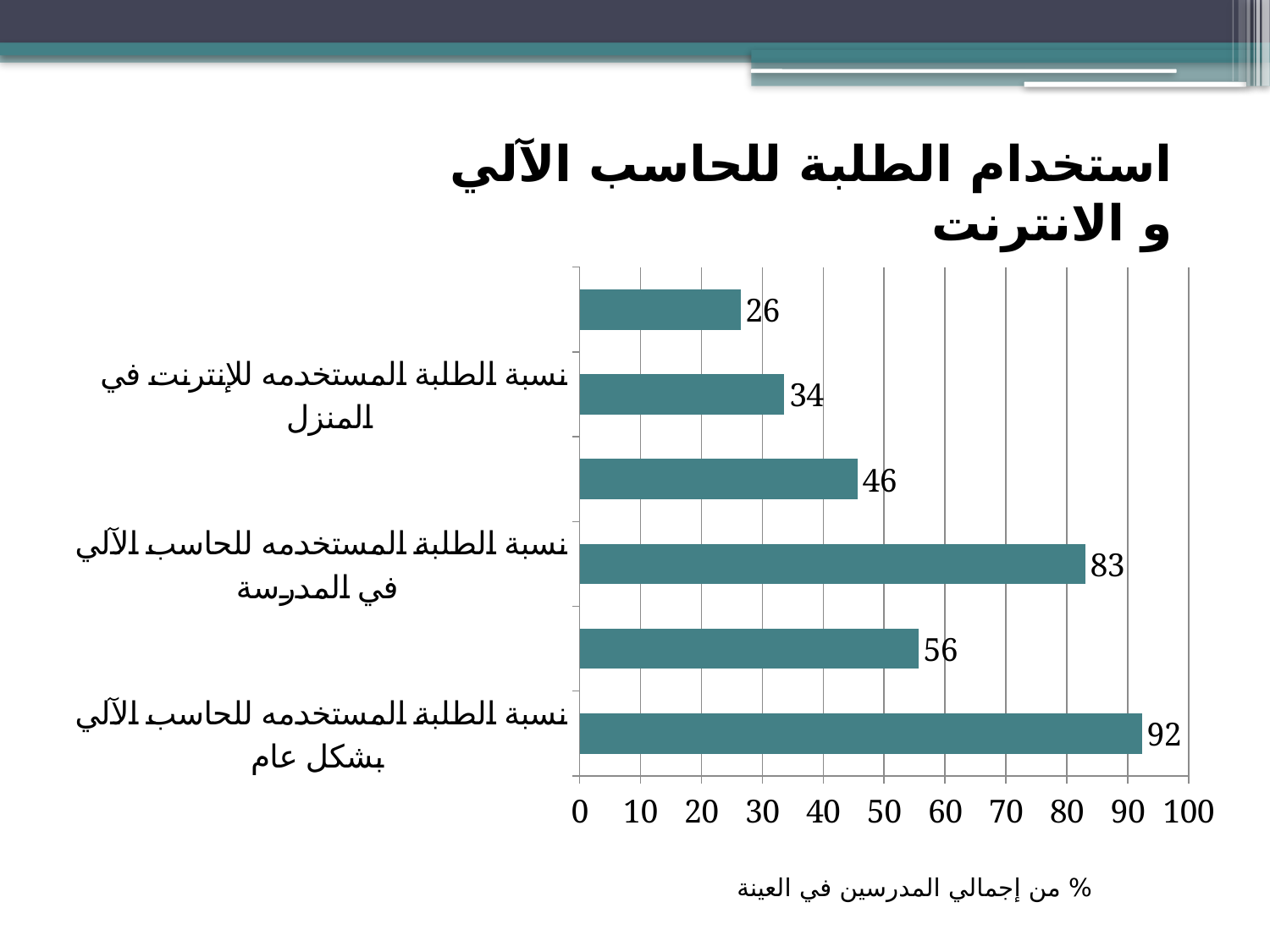
Is the value for نسبة الطلبة المستخدمه للإنترنت في المنزل greater or less than 50? less What is the difference between the value for نسبة الطلبة المستخدمه للحاسب الآلي بشكل عام and the value for نسبة الطلبة المستخدمه للحاسب الآلي في المدرسة? 9 How many bars are plotted in the chart? 6 What is the highest value shown in the chart? 92 What is the value for نسبة الطلبة المستخدمه للإنترنت في المنزل? 34 What is the title of the chart? استخدام الطلبة للحاسب الآلي و الانترنت What is the lowest value shown in the chart? 26 Which is larger: the value for نسبة الطلبة المستخدمه للحاسب الآلي في المدرسة or the value for نسبة الطلبة المستخدمه للإنترنت في المنزل? نسبة الطلبة المستخدمه للحاسب الآلي في المدرسة What is the maximum value shown on the horizontal axis? 100 What type of chart is shown on the slide? Bar chart What is the value for نسبة الطلبة المستخدمه للحاسب الآلي في المدرسة? 83 What is the value for نسبة الطلبة المستخدمه للحاسب الآلي بشكل عام? 92